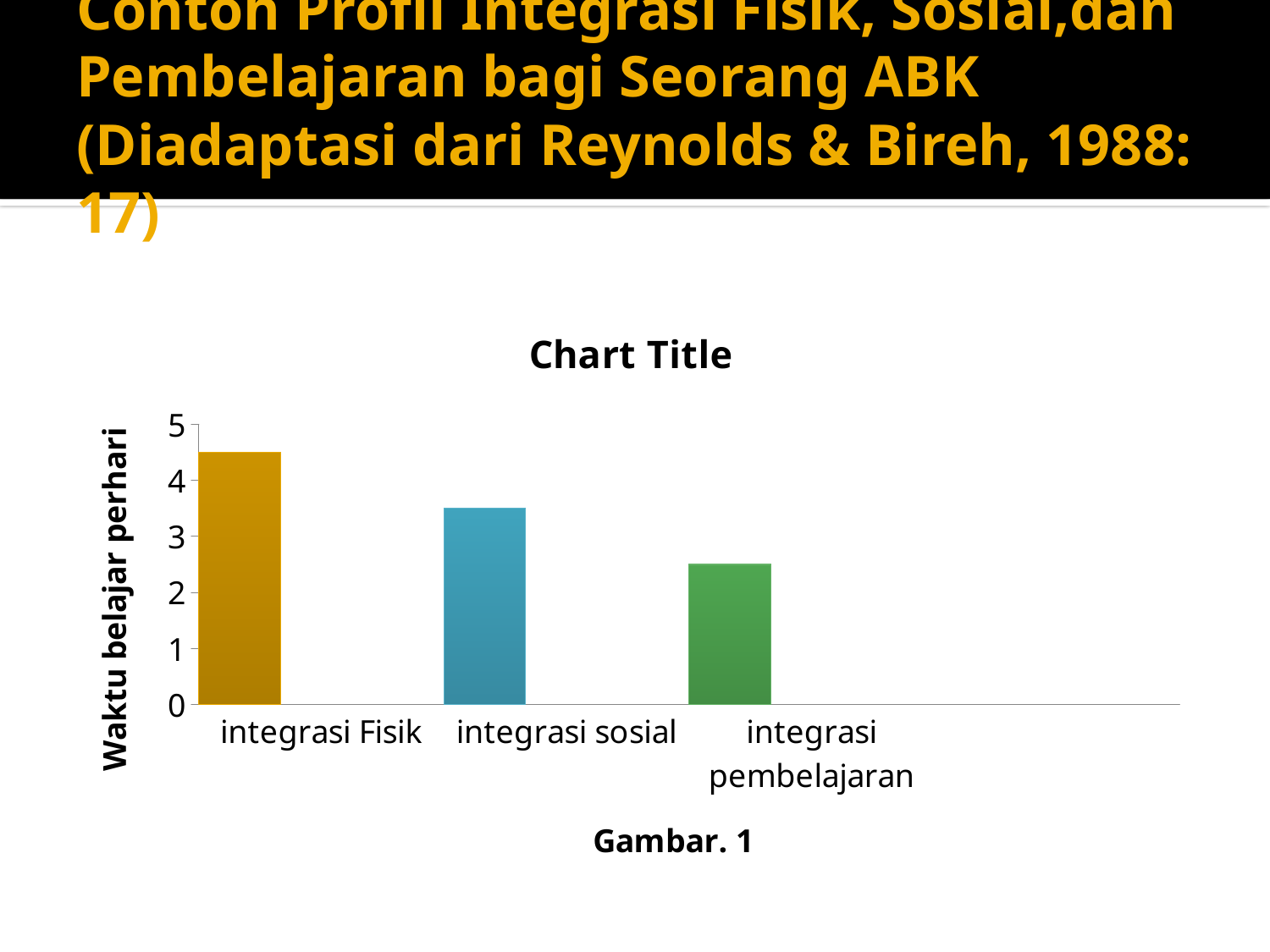
Is the value for integrasi Fisik greater or less than 4? greater What kind of chart is shown on the slide? bar chart How many categories are plotted in the chart? 3 What is the title shown above the chart? Chart Title Is the value for integrasi pembelajaran greater or less than 2? greater Which category has the lowest bar? integrasi pembelajaran What is the label on the vertical axis of the chart? Waktu belajar perhari Which is larger, the value for integrasi sosial or the value for integrasi pembelajaran? integrasi sosial Is the value for integrasi sosial greater or less than 3? greater Do the bar values rise or fall from left to right across the categories? fall Which category has the highest bar? integrasi Fisik